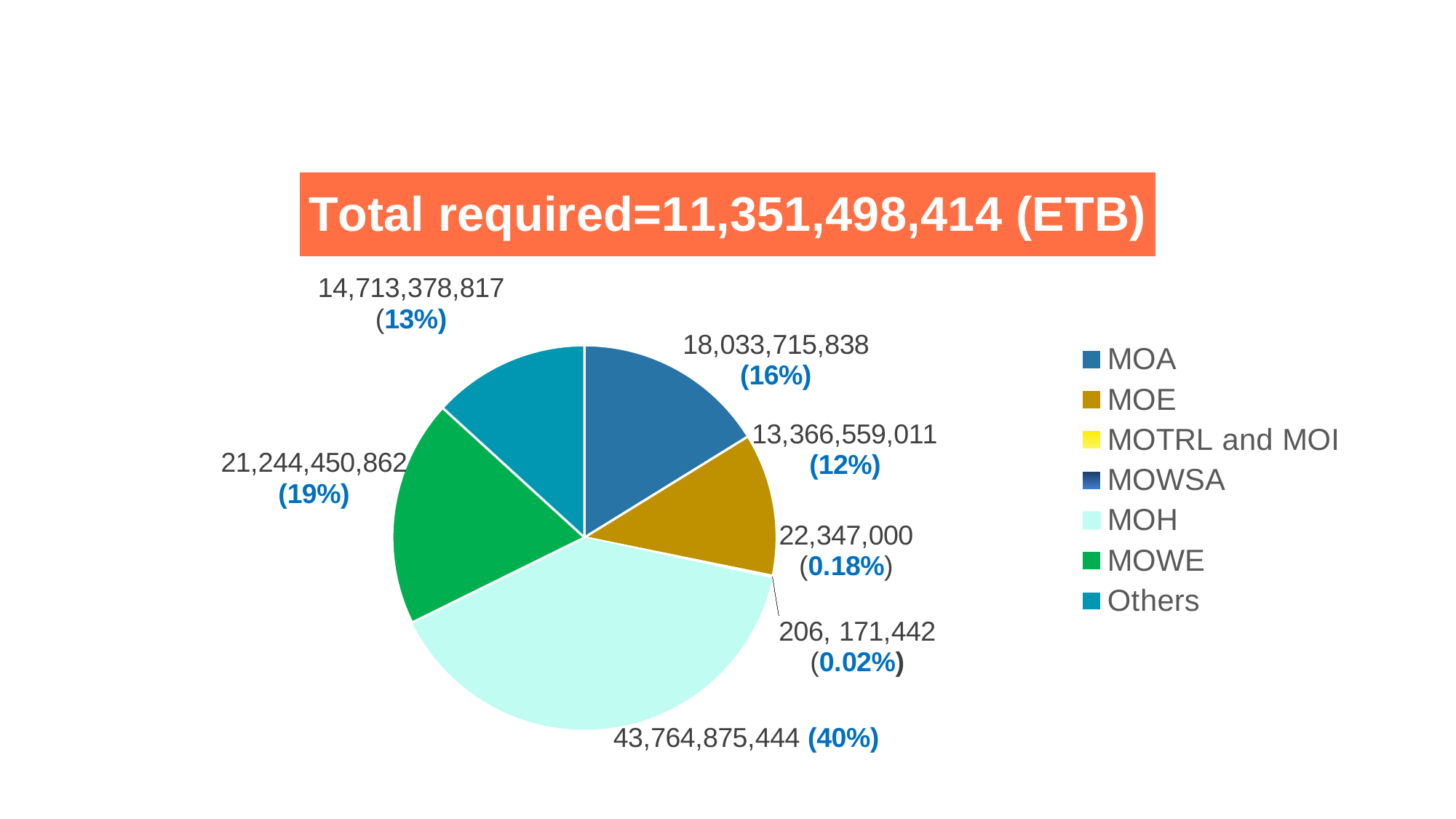
What is the value shown for MOA? 18,033,715,838 What share of the pie does MOH account for? 40% What total is stated in the title box above the chart? Total required=11,351,498,414 (ETB) What kind of chart is shown on the slide? Pie chart What is the value shown for MOE? 13,366,559,011 What is the difference between the values for MOWE and MOA? 3,210,735,024 What percentage share is shown for Others? 13% What is the value shown for MOH? 43,764,875,444 How many categories does the legend of the pie chart list? 7 Which category has the largest slice of the pie chart? MOH Which is larger, the slice for MOWE or the slice for MOA? MOWE What is the value shown for MOWE? 21,244,450,862